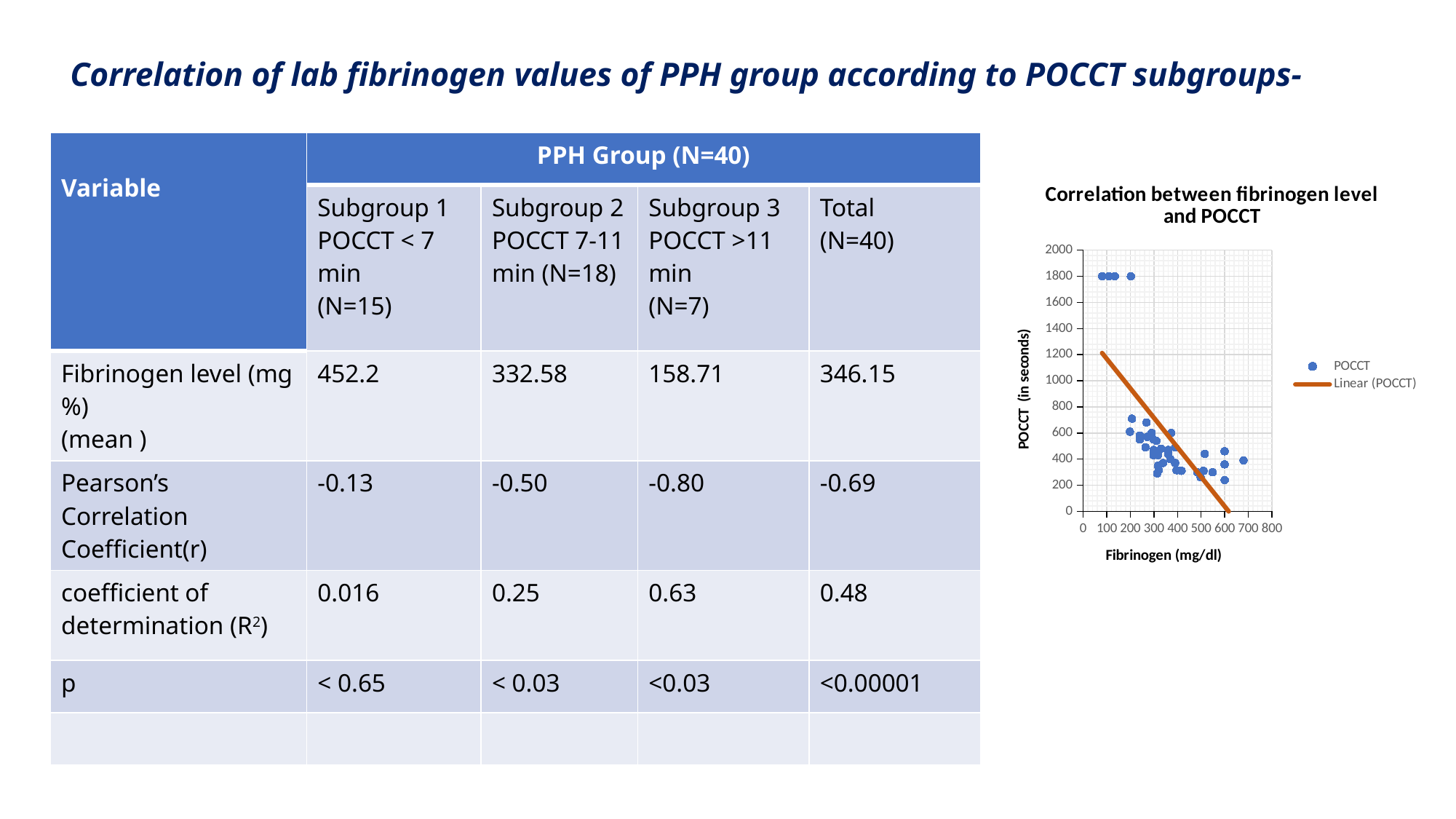
How many entries does the chart's legend list? 2 Are the highest POCCT values plotted in the chart greater or less than 1600 seconds? greater What is the label of the x axis of the chart? Fibrinogen (mg/dl) As fibrinogen increases along the x axis, does the trendline for POCCT rise or fall? fall What kind of chart is shown on the slide? scatter chart What is the highest tick value shown on the y axis of the chart? 2000 What is the highest tick value shown on the x axis of the chart? 800 Which has the higher POCCT values: the points near 100 mg/dl fibrinogen or the points near 600 mg/dl fibrinogen? the points near 100 mg/dl What is the name of the trendline series in the chart's legend? Linear (POCCT) Is the POCCT value of the point plotted at about 700 mg/dl fibrinogen greater or less than 600 seconds? less What is the title of the chart on the slide? Correlation between fibrinogen level and POCCT